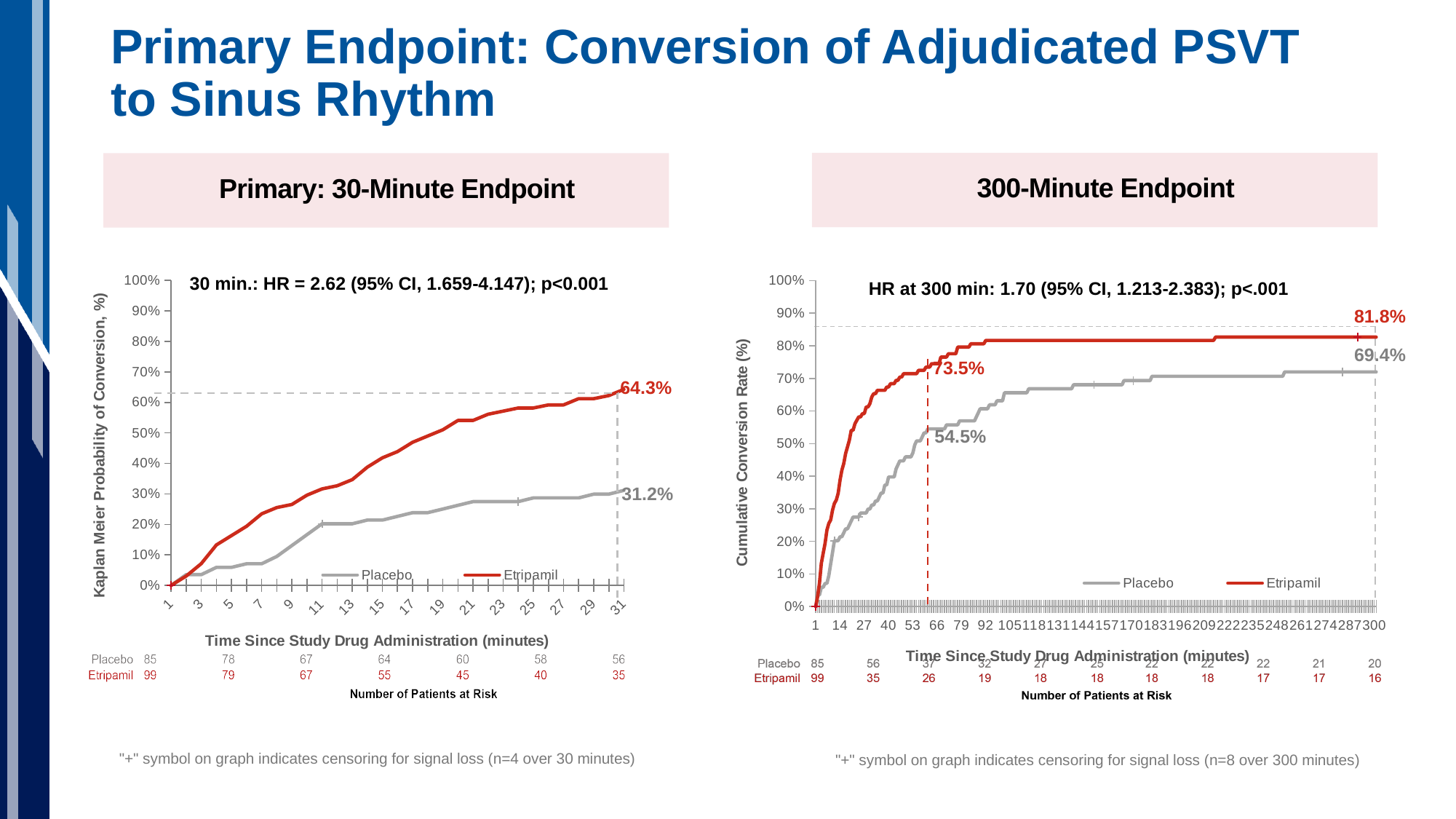
On the 300-Minute Endpoint chart, what are the two values labelled at the dashed vertical line near 60 minutes for Etripamil and Placebo? 73.5% and 54.5% On the 300-Minute Endpoint chart, what is the labelled cumulative conversion rate for Placebo at 300 minutes? 69.4% How many series does the legend of the Primary: 30-Minute Endpoint chart list? 2 On the Primary: 30-Minute Endpoint chart, is the Placebo value at 21 minutes greater or less than 30%? less On the 300-Minute Endpoint chart, what is the labelled cumulative conversion rate for Etripamil at 300 minutes? 81.8% On the 300-Minute Endpoint chart, what is the difference in percentage points between the Etripamil and Placebo values labelled at 300 minutes? 12.4 percentage points On the Primary: 30-Minute Endpoint chart, what is the difference in percentage points between the Etripamil and Placebo values labelled at 30 minutes? 33.1 percentage points On the Primary: 30-Minute Endpoint chart, what is the labelled conversion probability for Placebo at 30 minutes? 31.2% On the 300-Minute Endpoint chart, which series has the higher cumulative conversion rate at 300 minutes, Etripamil or Placebo? Etripamil On the Primary: 30-Minute Endpoint chart, what hazard ratio is stated in the annotation at 30 minutes? HR = 2.62 On the Primary: 30-Minute Endpoint chart, what is the labelled conversion probability for Etripamil at 30 minutes? 64.3% What kind of chart is the Primary: 30-Minute Endpoint chart? Line chart